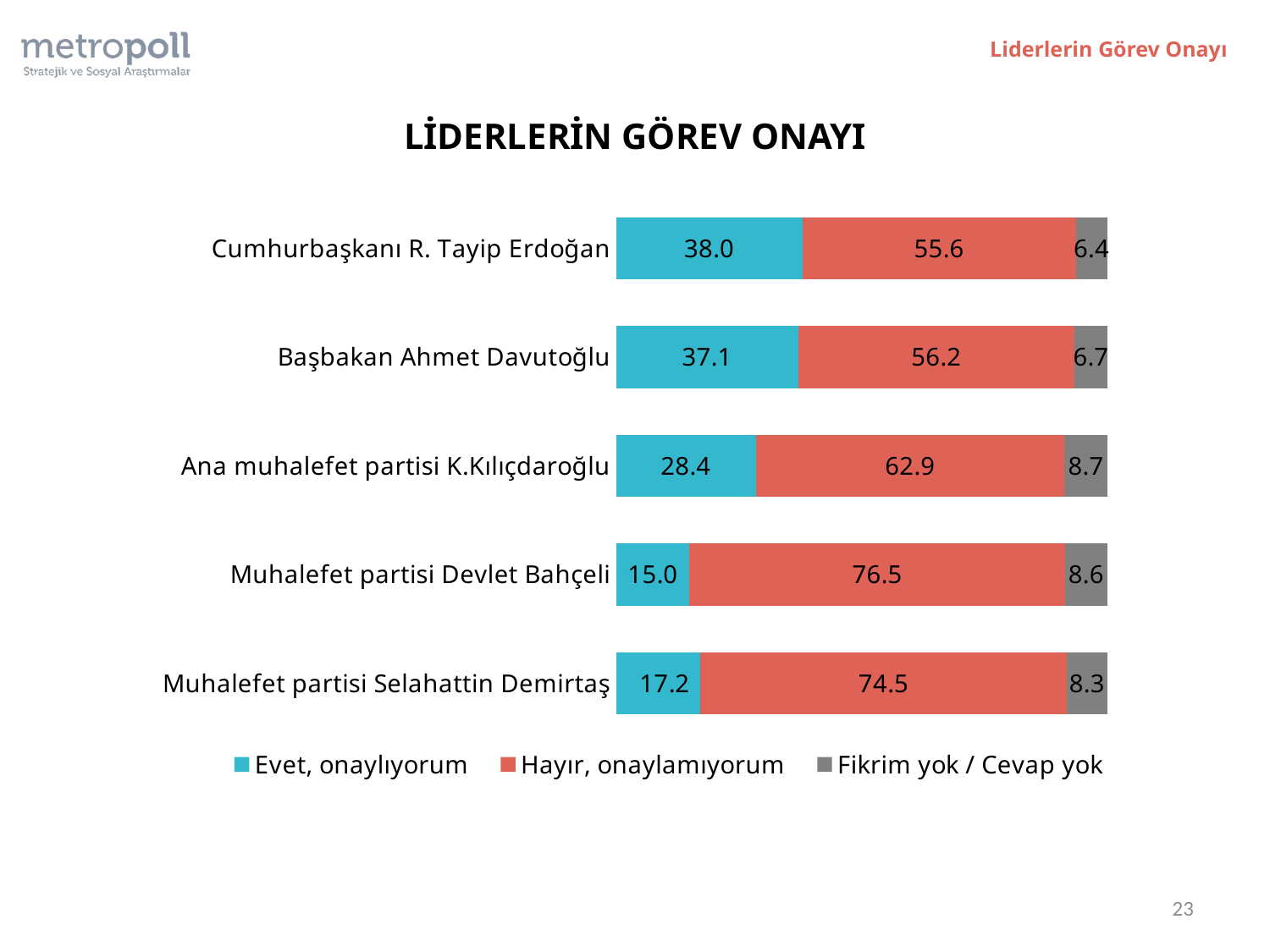
Which leader has the highest "Evet, onaylıyorum" value? Cumhurbaşkanı R. Tayip Erdoğan Which is larger: the "Evet, onaylıyorum" value for Başbakan Ahmet Davutoğlu or for Muhalefet partisi Selahattin Demirtaş? Başbakan Ahmet Davutoğlu Which leader has the lowest "Evet, onaylıyorum" value? Muhalefet partisi Devlet Bahçeli How many series does the legend list? 3 What is the "Hayır, onaylamıyorum" value for Muhalefet partisi Devlet Bahçeli? 76.5 What is the "Fikrim yok / Cevap yok" value for Ana muhalefet partisi K.Kılıçdaroğlu? 8.7 What kind of chart is shown on the slide? Stacked bar chart What is the "Evet, onaylıyorum" value for Cumhurbaşkanı R. Tayip Erdoğan? 38.0 What is the title of the chart? LİDERLERİN GÖREV ONAYI How many leaders are shown in the chart? 5 What is the difference between the "Hayır, onaylamıyorum" values for Muhalefet partisi Devlet Bahçeli and Cumhurbaşkanı R. Tayip Erdoğan? 20.9 What is the total of the stacked bar for Başbakan Ahmet Davutoğlu? 100.0